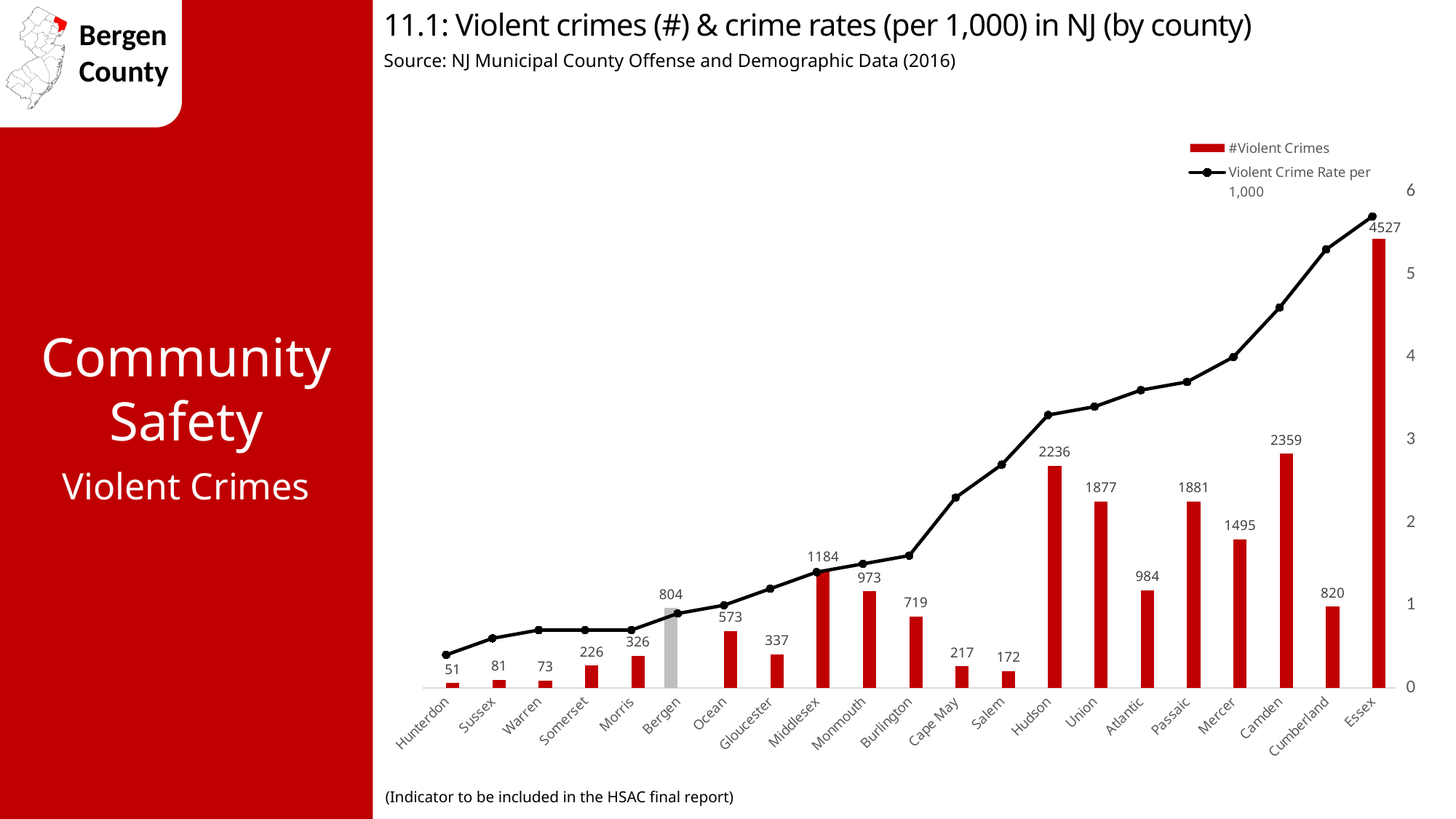
How many series does the legend list? 2 What is the source cited for the chart? NJ Municipal County Offense and Demographic Data (2016) Does the violent crime rate per 1,000 line generally rise or fall from Hunterdon to Essex? rise What is the number of violent crimes for Essex? 4527 Which county has the lowest number of violent crimes? Hunterdon How many counties are shown on the x axis? 21 Which county has the highest number of violent crimes? Essex Is the violent crime rate per 1,000 for Essex greater or less than 5? greater Is the violent crime rate per 1,000 for Hunterdon greater or less than 1? less What is the difference in the number of violent crimes between Camden and Hudson? 123 How many violent crimes are shown for Bergen County? 804 Which has more violent crimes, Union or Passaic? Passaic